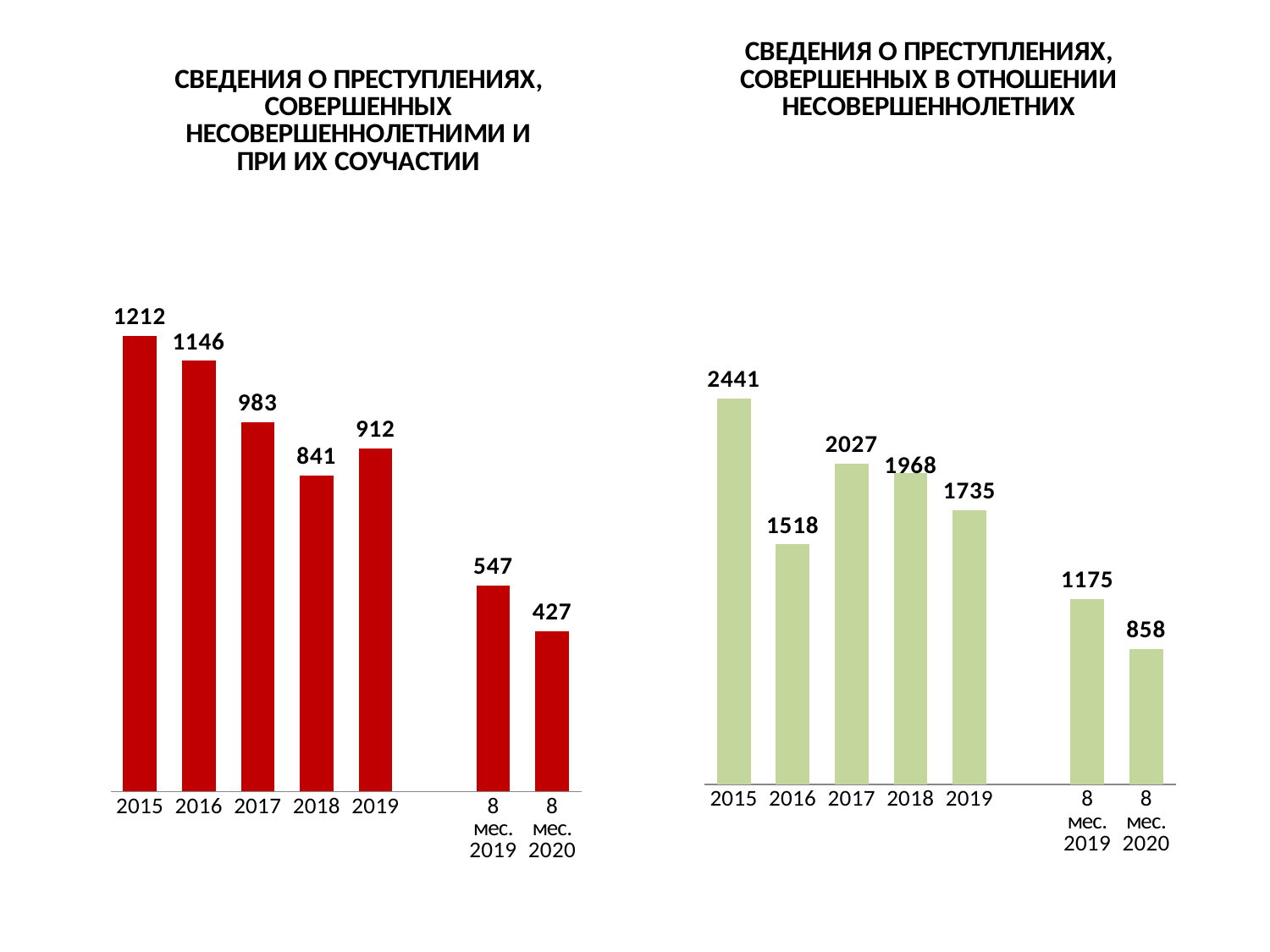
What type of chart is the left chart (crimes committed by minors and with their participation)? bar chart In the right chart (crimes committed against minors), do the values rise or fall from 2017 to 2019? fall In the left chart (crimes committed by minors and with their participation), which category has the highest value? 2015 In the left chart (crimes committed by minors and with their participation), which is larger: the value for 2018 or the value for 2019? 2019 In the right chart (crimes committed against minors), what is the value for 2017? 2027 In the right chart (crimes committed against minors), what is the difference between the values for 2015 and 2016? 923 How many bars are shown in the right chart (crimes committed against minors)? 7 In the left chart (crimes committed by minors and with their participation), what is the difference between the values for 8 months of 2019 and 8 months of 2020? 120 In the right chart (crimes committed against minors), which category has the lowest value? 8 мес. 2020 In the right chart (crimes committed against minors), what is the value for 8 months of 2019? 1175 In the left chart (crimes committed by minors and with their participation), what is the value for 2015? 1212 In the left chart (crimes committed by minors and with their participation), what is the value for 8 months of 2020? 427